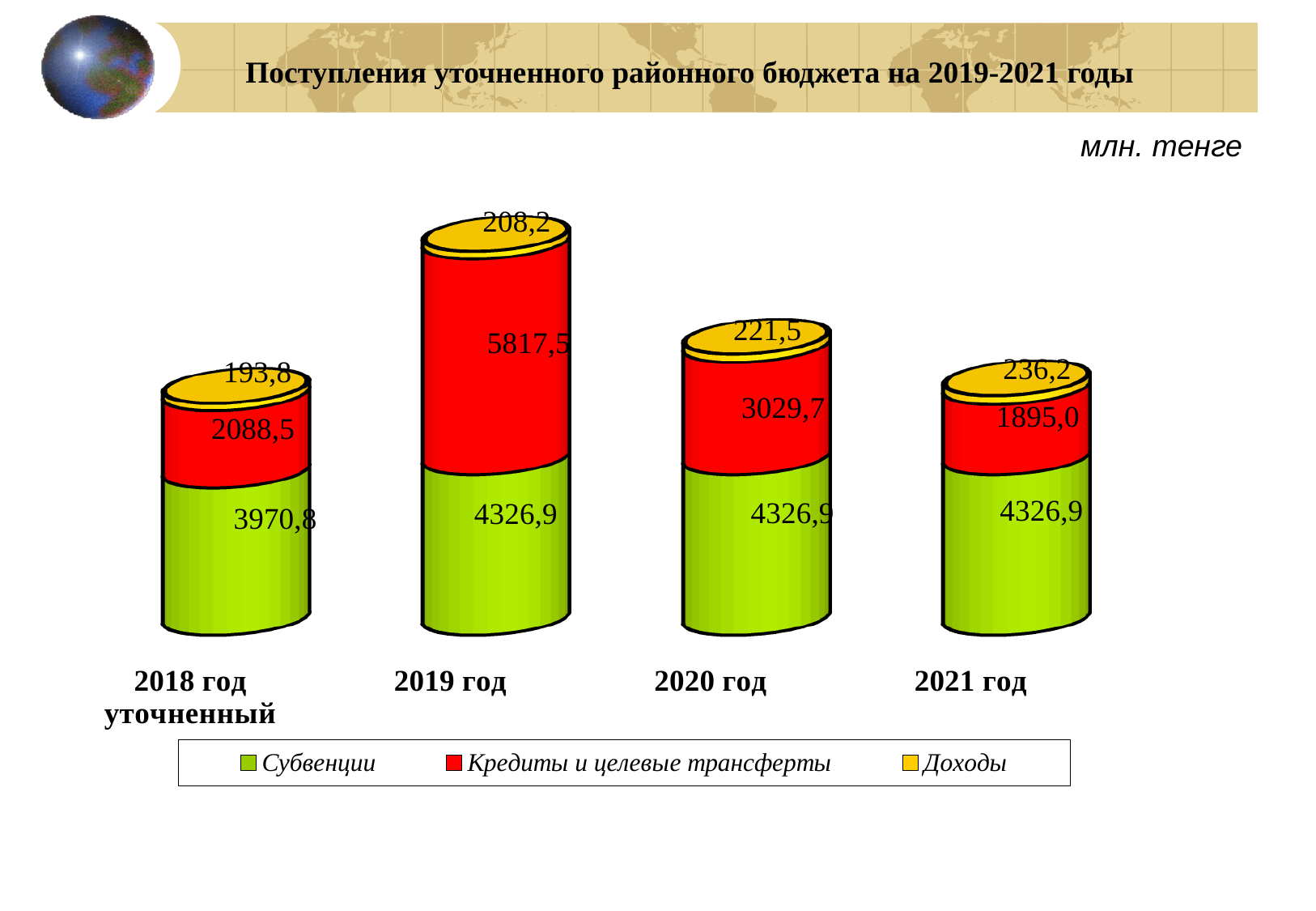
How many years are shown on the chart? 4 What is the value of Доходы for 2021 год? 236,2 What is the total of the stacked bar for 2021 год? 6458,1 What is the value of Субвенции for 2018 год уточненный? 3970,8 What unit is stated for the values on the chart? млн. тенге Which year has the lowest value for Доходы? 2018 год уточненный Which is larger: Кредиты и целевые трансферты in 2020 год or in 2021 год? 2020 год What is the value of Кредиты и целевые трансферты for 2019 год? 5817,5 How many series does the legend list? 3 What is the difference between Кредиты и целевые трансферты in 2019 год and 2020 год? 2787,8 What kind of chart is shown on the slide? Stacked bar chart Which year has the highest value for Кредиты и целевые трансферты? 2019 год